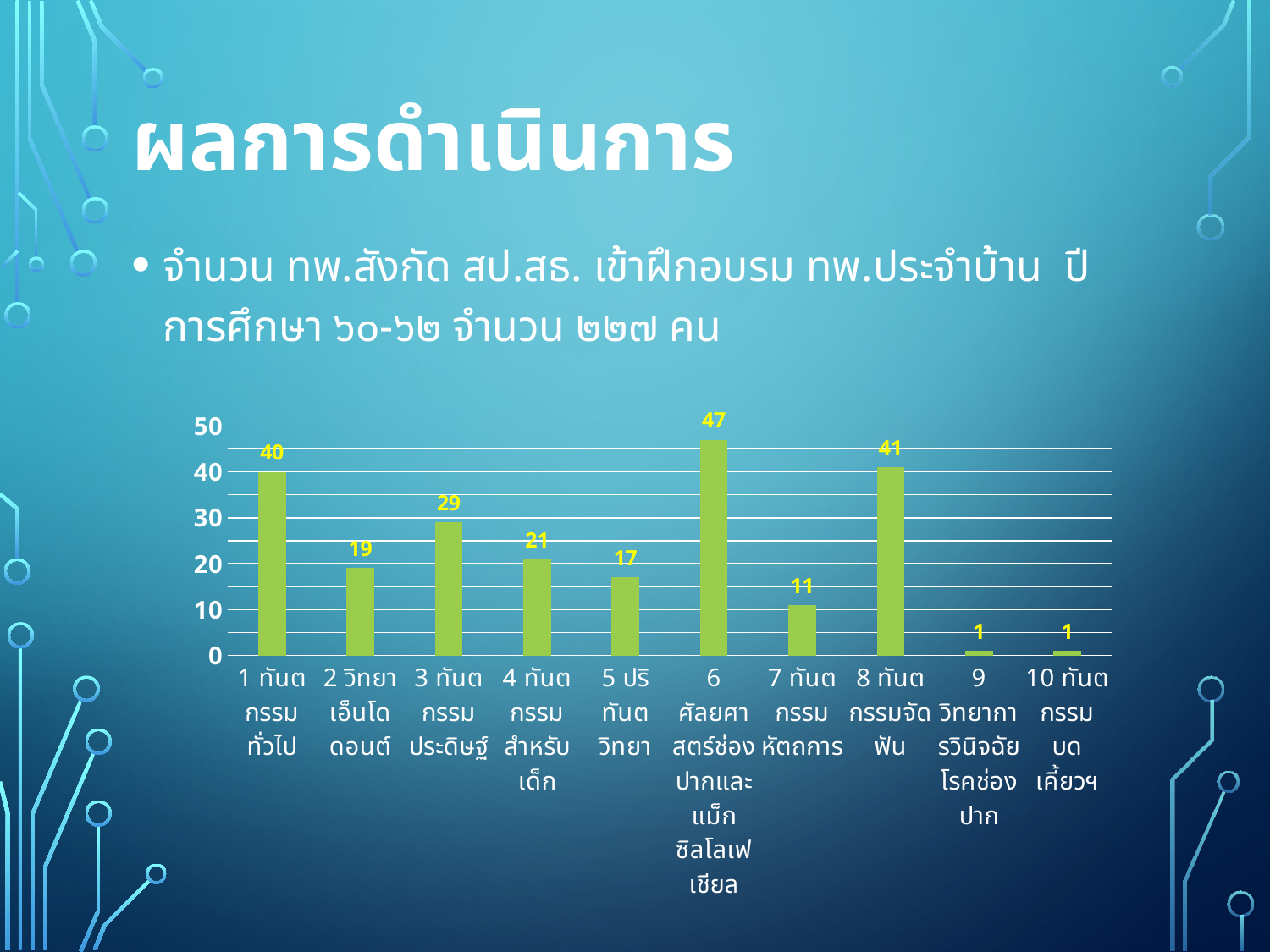
What is the value for category 5 ปริทันตวิทยา? 17 What is the value for category 8 ทันตกรรมจัดฟัน? 41 How many categories are shown on the x axis of the chart? 10 Is the value for 7 ทันตกรรมหัตถการ greater or less than 20? less Which is larger, the value for 3 ทันตกรรมประดิษฐ์ or the value for 4 ทันตกรรมสำหรับเด็ก? 3 ทันตกรรมประดิษฐ์ What is the value for category 6 ศัลยศาสตร์ช่องปากและแม็กซิลโลเฟเชียล? 47 What is the difference between the values for 1 ทันตกรรมทั่วไป and 2 วิทยาเอ็นโดดอนต์? 21 Which category has the highest value? 6 ศัลยศาสตร์ช่องปากและแม็กซิลโลเฟเชียล What is the lowest value shown in the chart? 1 What is the value for category 1 ทันตกรรมทั่วไป? 40 What colour are the bars in the chart? green What kind of chart is shown on the slide? bar chart